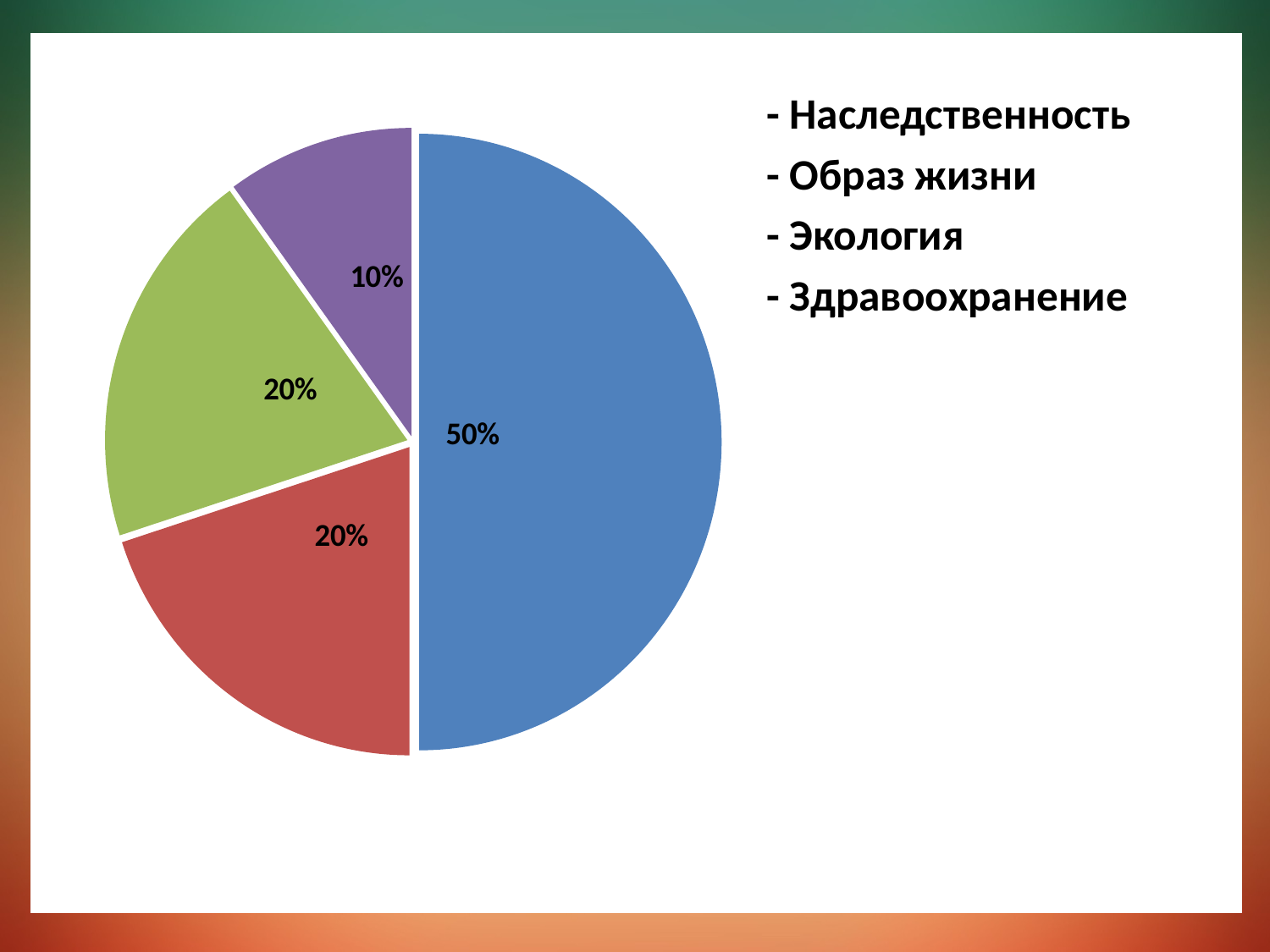
What is the difference between the blue slice and the purple slice of the pie chart? 40% What value is labelled on the red slice of the pie chart? 20% How many slices does the pie chart have? 4 What colour is the largest slice of the pie chart? blue What is the value of the smallest slice of the pie chart? 10% What value is labelled on the purple slice of the pie chart? 10% What is the value of the largest slice of the pie chart? 50% How many items are listed in the text to the right of the pie chart? 4 What value is labelled on the green slice of the pie chart? 20% What kind of chart is shown on the slide? pie chart Which slice is larger, the blue slice or the red slice? blue What value is labelled on the blue slice of the pie chart? 50%